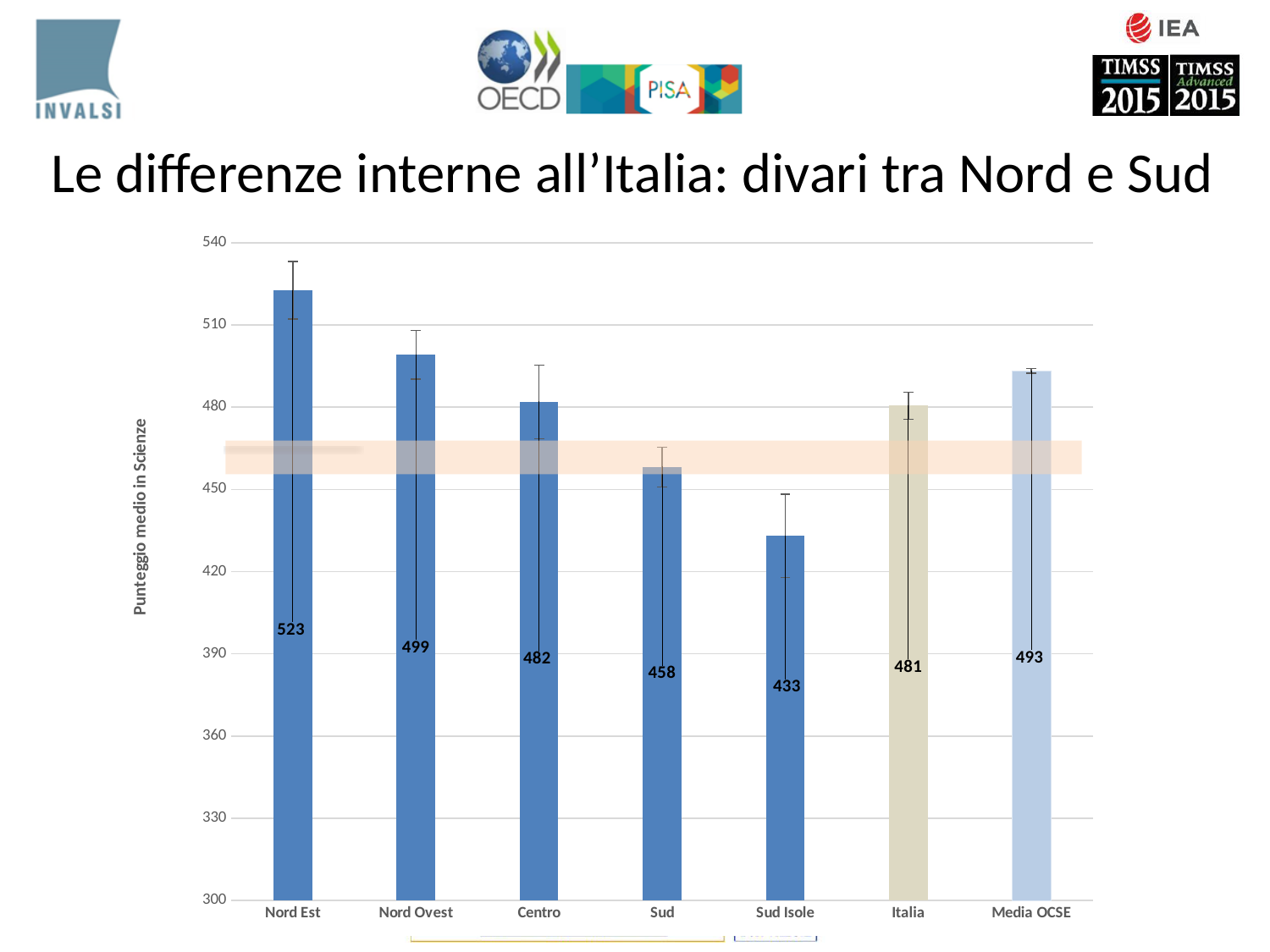
What is the value for Italia? 481 Is the value for Sud greater or less than 480? less How many categories are shown on the x axis? 7 What is the label of the vertical axis? Punteggio medio in Scienze Which is larger, the value for Nord Ovest or the value for Media OCSE? Nord Ovest What is the value for Nord Est? 523 What is the value for Sud Isole? 433 What kind of chart is shown on the slide? bar chart Which category has the highest value? Nord Est Which category has the lowest value? Sud Isole What is the value for Media OCSE? 493 What is the difference between the values for Nord Est and Sud Isole? 90